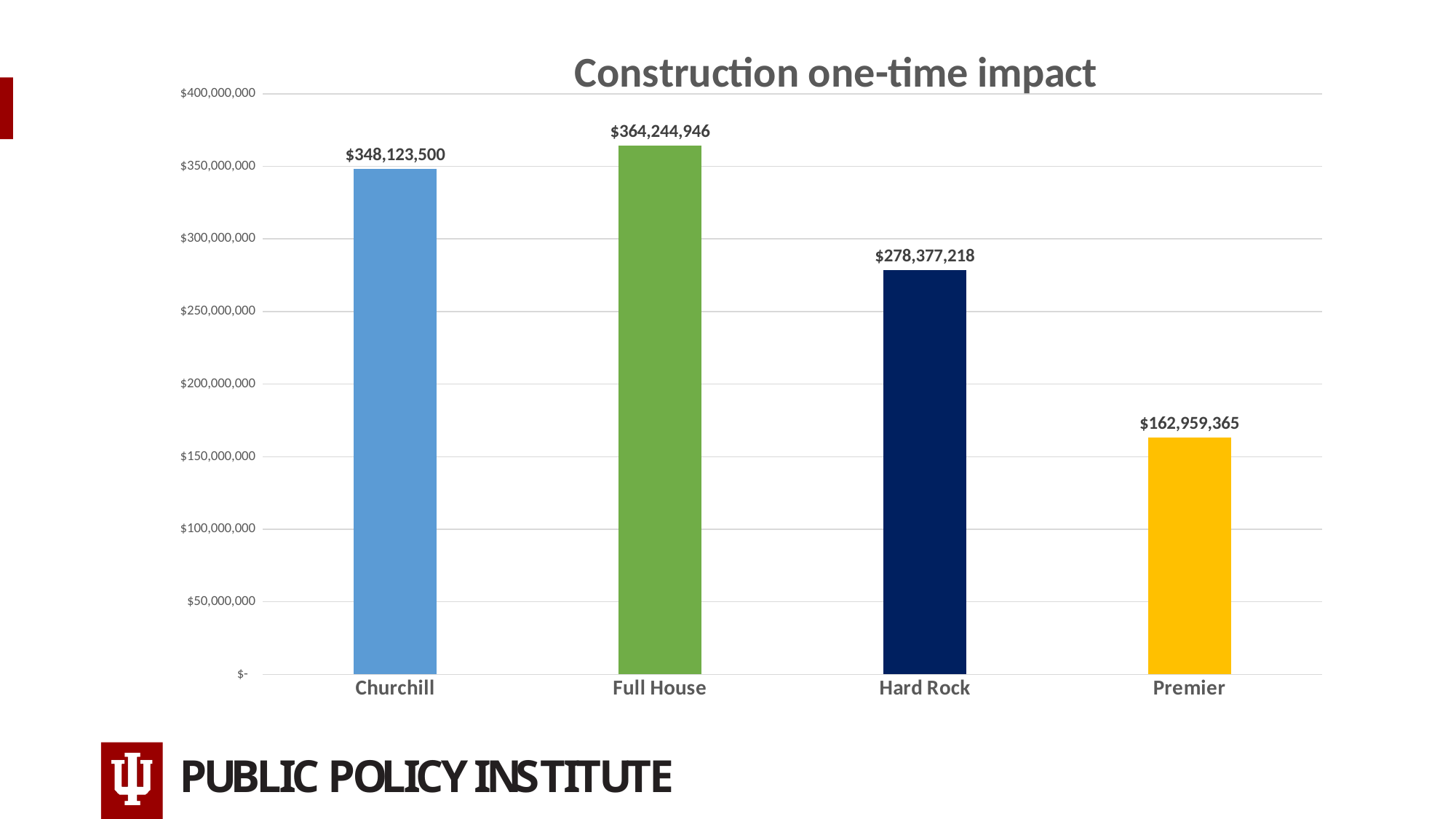
Which category has the lowest construction one-time impact? Premier What is the construction one-time impact for Full House? $364,244,946 What type of chart is shown on the slide? Bar chart What is the construction one-time impact for Churchill? $348,123,500 How much larger is the construction one-time impact for Full House than for Churchill? $16,121,446 What is the construction one-time impact for Hard Rock? $278,377,218 How many categories are shown in the chart? 4 What is the construction one-time impact for Premier? $162,959,365 Which category has the highest construction one-time impact? Full House Which has a larger construction one-time impact, Churchill or Hard Rock? Churchill Is the value for Premier greater or less than $200,000,000? less What is the difference between the construction one-time impact for Hard Rock and for Premier? $115,417,853